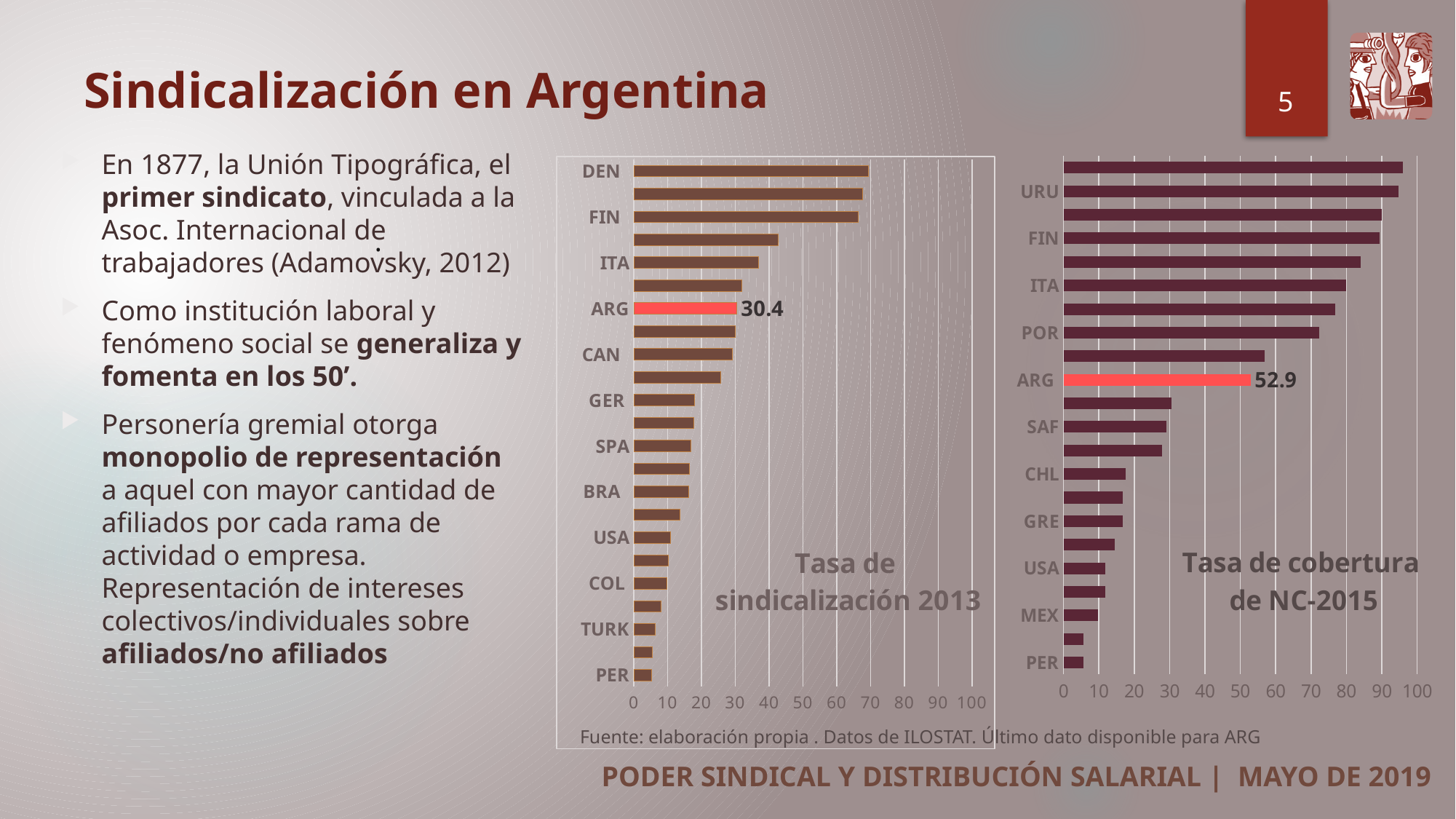
In the 'Tasa de cobertura de NC-2015' chart, is the value for URU greater or less than 90? greater In the 'Tasa de sindicalización 2013' chart, is the value for TURK greater or less than 10? less What is the difference between the ARG value in the 'Tasa de cobertura de NC-2015' chart and the ARG value in the 'Tasa de sindicalización 2013' chart? 22.5 In the 'Tasa de cobertura de NC-2015' chart, what is the value for ARG? 52.9 Is the value for ARG larger in the 'Tasa de sindicalización 2013' chart or in the 'Tasa de cobertura de NC-2015' chart? Tasa de cobertura de NC-2015 What kind of chart is the 'Tasa de sindicalización 2013' chart? Bar chart In both charts, which country's bar is highlighted in a different colour (red) from the others? ARG In the 'Tasa de cobertura de NC-2015' chart, which is larger, the value for ARG or the value for USA? ARG In the 'Tasa de sindicalización 2013' chart, is the value for DEN greater or less than 60? greater In the 'Tasa de sindicalización 2013' chart, what is the value for ARG? 30.4 Which labeled country has the highest value in the 'Tasa de sindicalización 2013' chart? DEN